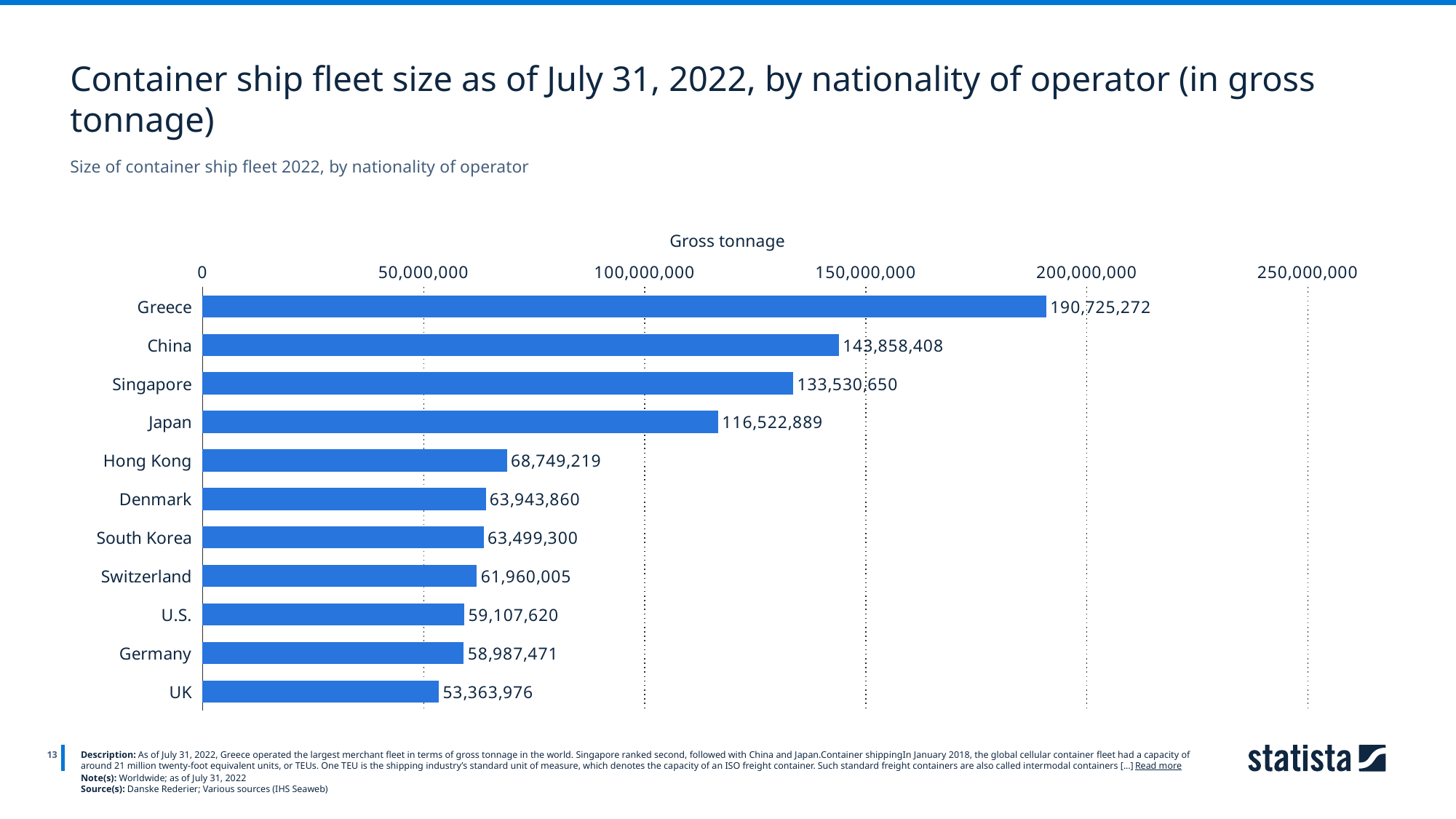
How many nationalities of operator are shown in the chart? 11 What is the gross tonnage for Japan? 116,522,889 Which nationality of operator has the largest container ship fleet? Greece Which has a larger gross tonnage, Singapore or Japan? Singapore What is the label of the value axis on the chart? Gross tonnage Which nationality of operator has the smallest container ship fleet shown? UK What kind of chart is shown on the slide? Bar chart What is the difference in gross tonnage between Japan and Hong Kong? 47,773,670 What is the gross tonnage for Greece? 190,725,272 What is the gross tonnage for Switzerland? 61,960,005 Is the value for China greater or less than 150,000,000? less What is the difference in gross tonnage between Greece and China? 46,866,864